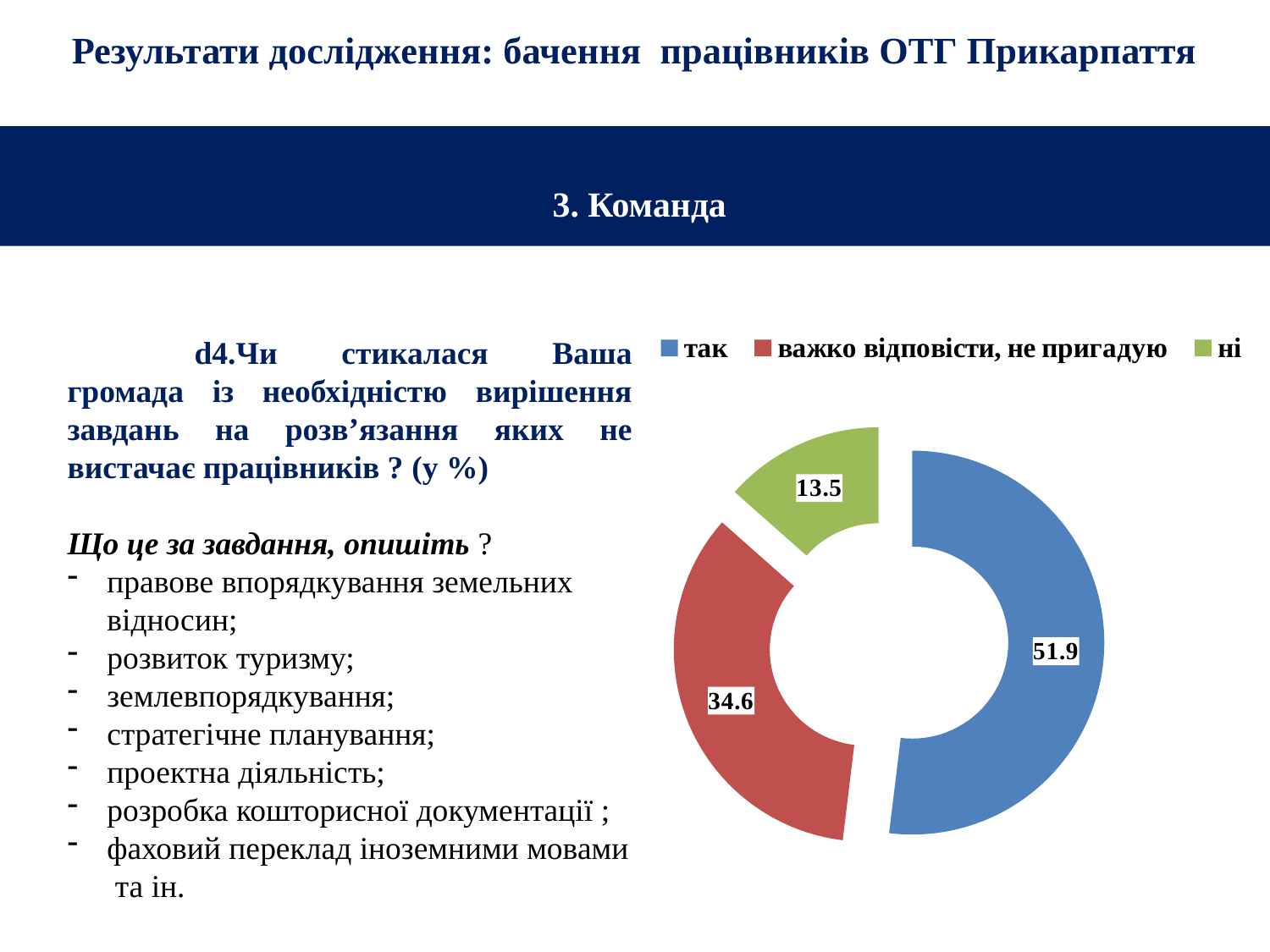
Which category has the smallest slice? ні What colour is the "ні" slice? Green What is the difference between the "так" value and the "ні" value? 38.4 What value is shown for the "так" slice? 51.9 How many slices does the chart have? 3 How many entries does the legend list? 3 What kind of chart is shown on the slide? Doughnut (pie) chart Which category has the largest slice? так Which is larger, the "важко відповісти, не пригадую" slice or the "ні" slice? важко відповісти, не пригадую What value is shown for the "ні" slice? 13.5 What is the difference between the "так" value and the "важко відповісти, не пригадую" value? 17.3 What value is shown for the "важко відповісти, не пригадую" slice? 34.6